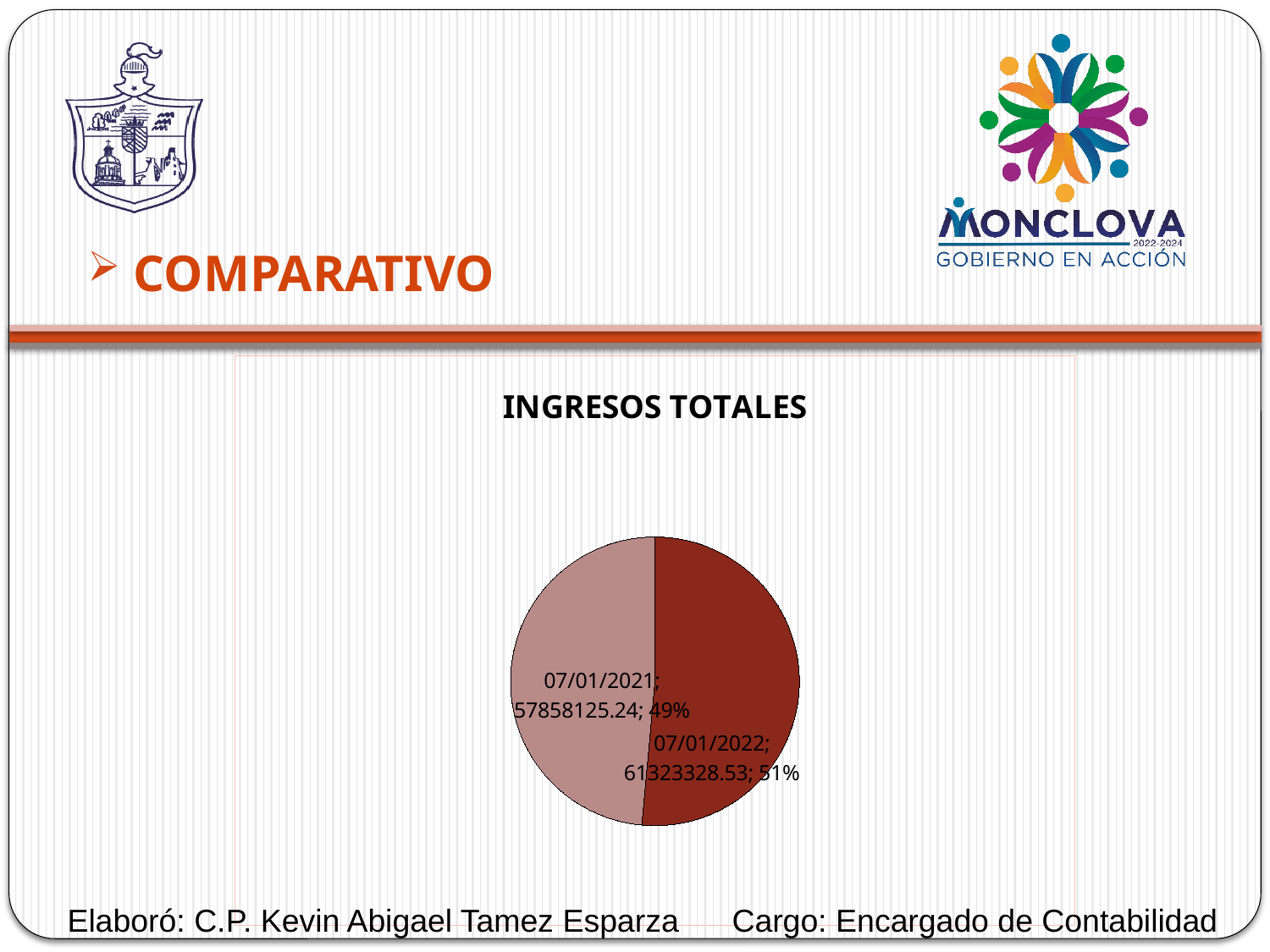
What share of the pie does 07/01/2021 represent? 49% What type of chart is shown on the slide? pie chart Which is larger, the value for 07/01/2021 or 07/01/2022? 07/01/2022 What is the difference between the values for 07/01/2022 and 07/01/2021? 3465203.29 How many slices does the pie chart have? 2 What is the value for 07/01/2022? 61323328.53 Which slice is the largest? 07/01/2022 What is the value for 07/01/2021? 57858125.24 What is the total of the two values shown in the pie chart? 119181453.77 What is the title of the chart? INGRESOS TOTALES Which slice is the smallest? 07/01/2021 What share of the pie does 07/01/2022 represent? 51%